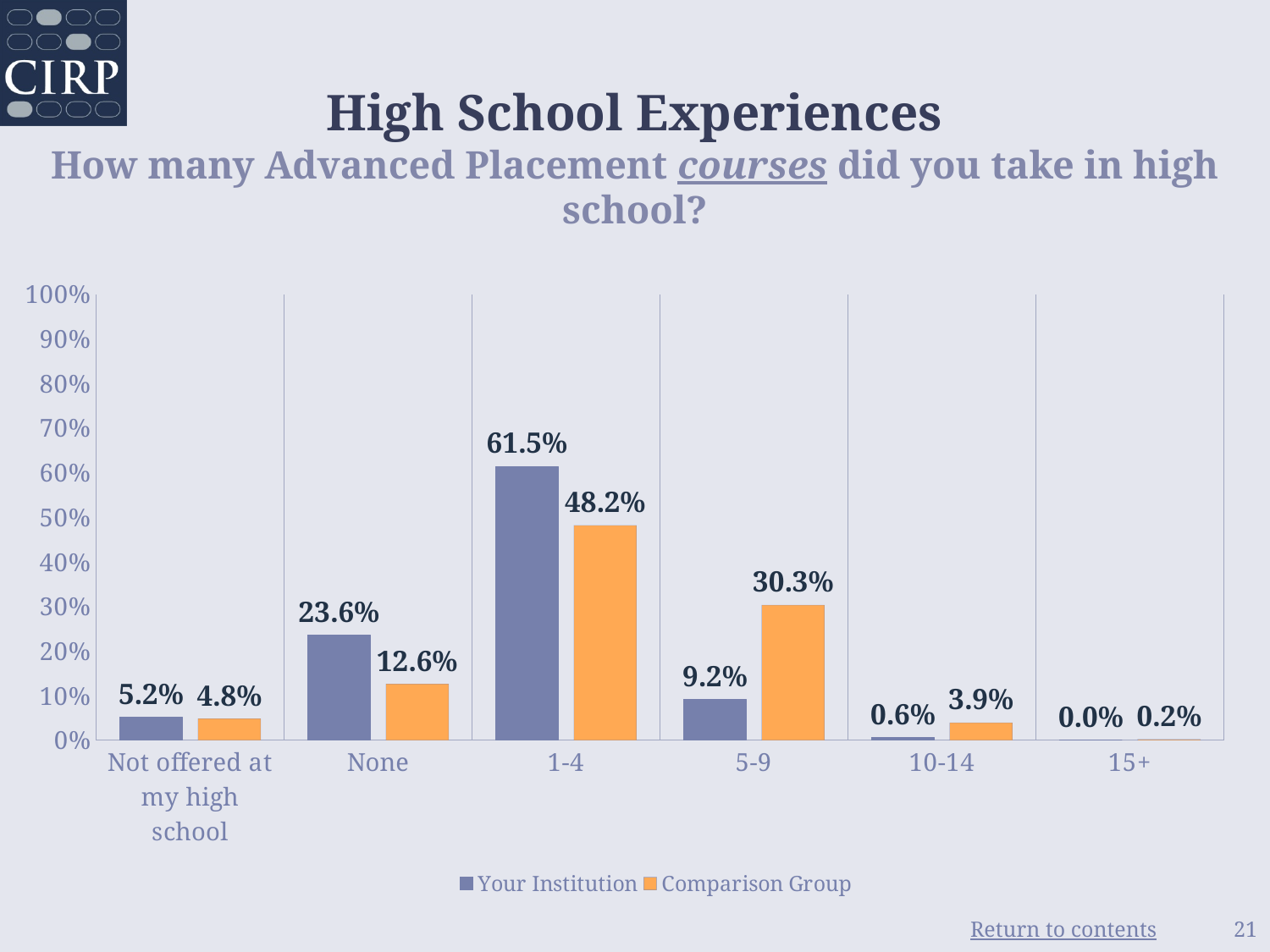
What is the Your Institution value for the None category? 23.6% What is the difference between Your Institution and the Comparison Group for the 1-4 category? 13.3% What percentage of Your Institution students took 1-4 Advanced Placement courses? 61.5% Which category has the highest value for the Comparison Group? 1-4 For the None category, which series has the larger value, Your Institution or Comparison Group? Your Institution What kind of chart is shown on the slide? Bar chart What is the difference between the Comparison Group and Your Institution for the 5-9 category? 21.1% For the 10-14 category, which series has the larger value, Your Institution or Comparison Group? Comparison Group What is the Comparison Group value for the 5-9 category? 30.3% How many categories are shown on the x axis? 6 How many series does the legend list? 2 Which category has the lowest value for Your Institution? 15+